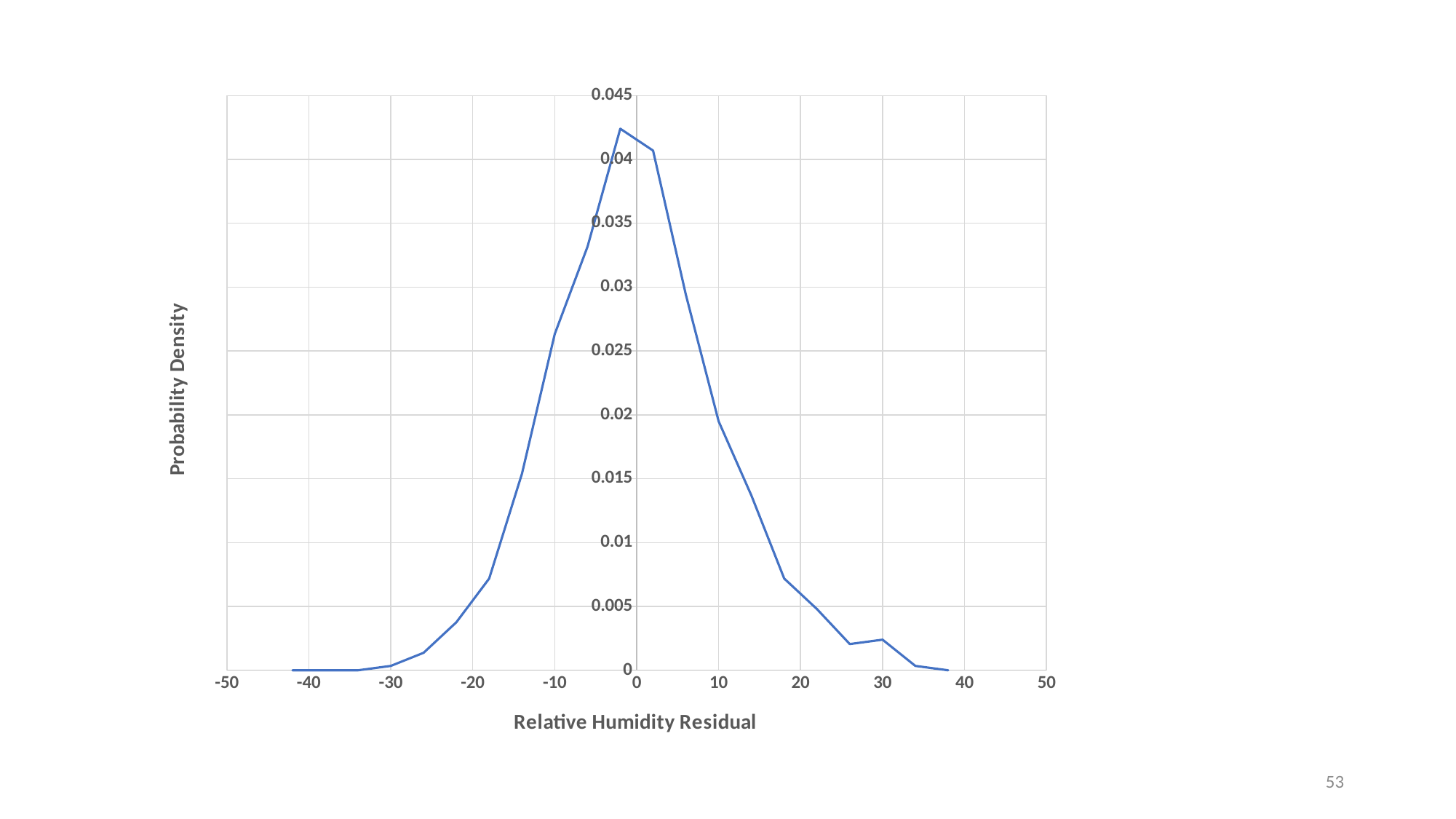
Which is larger, the probability density at a residual of -30 or at a residual of 30? 30 What kind of chart is shown on the slide? line chart Does the probability density rise or fall as the relative humidity residual increases from 0 to 40? fall Is the value at a relative humidity residual of 14 greater or less than 0.015? less What is the title of the x axis? Relative Humidity Residual Is the peak value of the line greater or less than 0.04? greater Is the value at a relative humidity residual of -6 greater or less than 0.035? less Which is larger, the probability density at a residual of -10 or at a residual of 10? -10 What is the title of the y axis? Probability Density